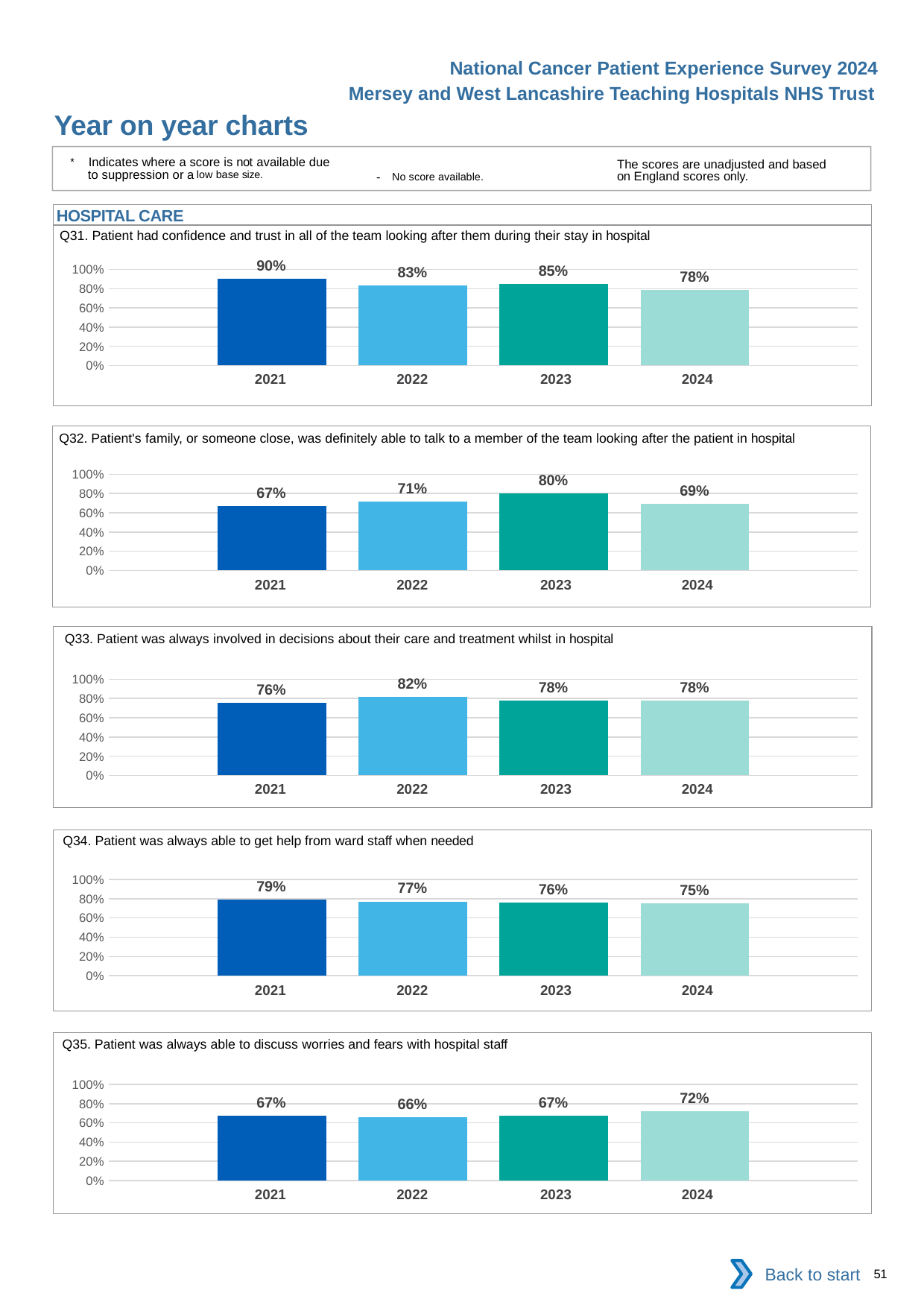
In the Q32 chart, which year has the highest value? 2023 In the Q33 chart, which is larger, the value for 2021 or the value for 2022? 2022 In the Q31 chart, what is the value for 2021? 90% In the Q35 chart, which year has the highest value? 2024 What kind of chart is the Q34 chart? bar chart How many years are shown in the Q31 chart? 4 In the Q31 chart, which year has the lowest value? 2024 In the Q33 chart, what is the value for 2022? 82% In the Q34 chart, what is the value for 2024? 75% In the Q34 chart, do the values rise or fall from 2021 to 2024? fall In the Q35 chart, what is the difference between the 2024 and 2022 values? 6% In the Q32 chart, what is the difference between the 2023 and 2021 values? 13%